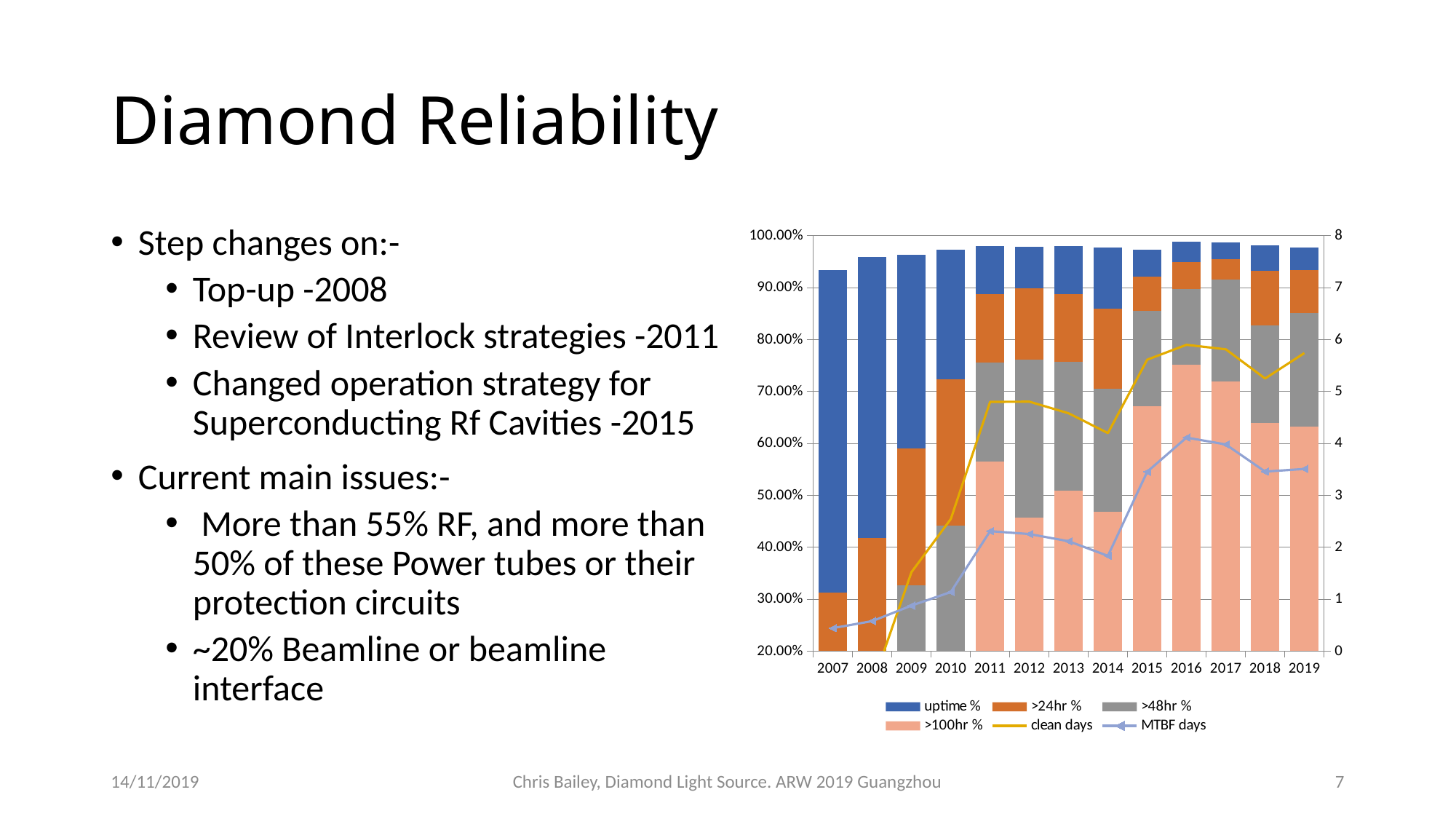
Which legend entry is shown with a yellow line? clean days How many series does the chart legend list? 6 In which year is the top of the uptime % bar lowest? 2007 Is the MTBF days value for 2007 greater or less than 1? less Is the top of the >100hr % bar for 2016 greater or less than 70.00%? greater Is the MTBF days value for 2014 greater or less than 2? less What kind of chart is shown on the slide? Bar chart combined with line series In which year is the MTBF days line at its highest? 2016 Which year has the larger MTBF days value, 2014 or 2016? 2016 Does the MTBF days line generally rise or fall from 2007 to 2019? rise How many years are shown on the x axis of the chart? 13